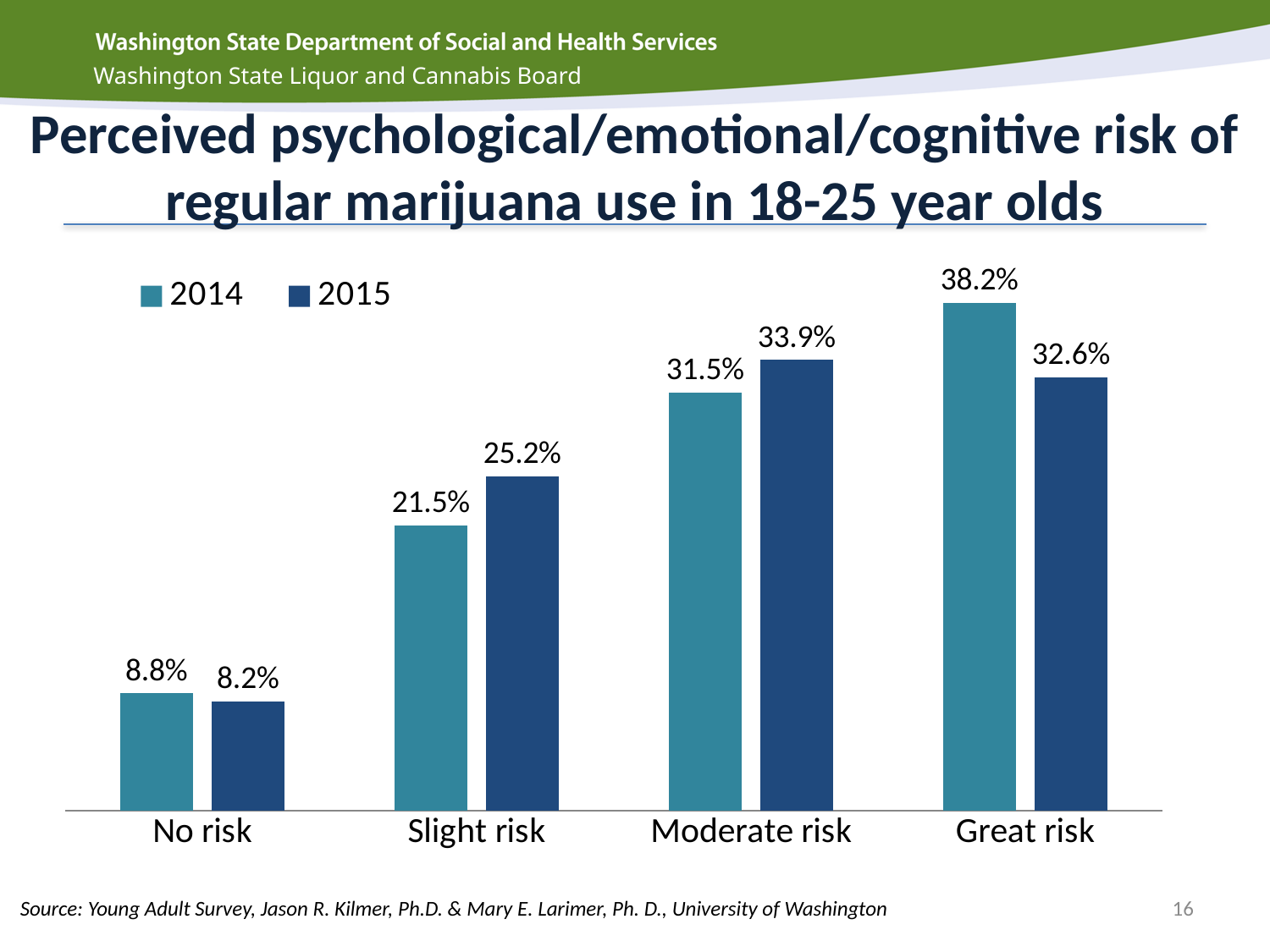
What kind of chart is shown on the slide? Bar chart How many categories are shown on the x axis? 4 What is the difference between the 2014 and 2015 values for Great risk? 5.6% What is the 2015 value for No risk? 8.2% Which category has the lowest 2014 value? No risk What is the 2015 value for Slight risk? 25.2% What is the difference between the 2015 values for Moderate risk and Slight risk? 8.7% Which is larger, the 2014 value for Moderate risk or the 2015 value for Moderate risk? 2015 Which category has the highest 2015 value? Moderate risk Which series is shown in the darker blue colour? 2015 How many series does the legend list? 2 What is the 2014 value for Great risk? 38.2%